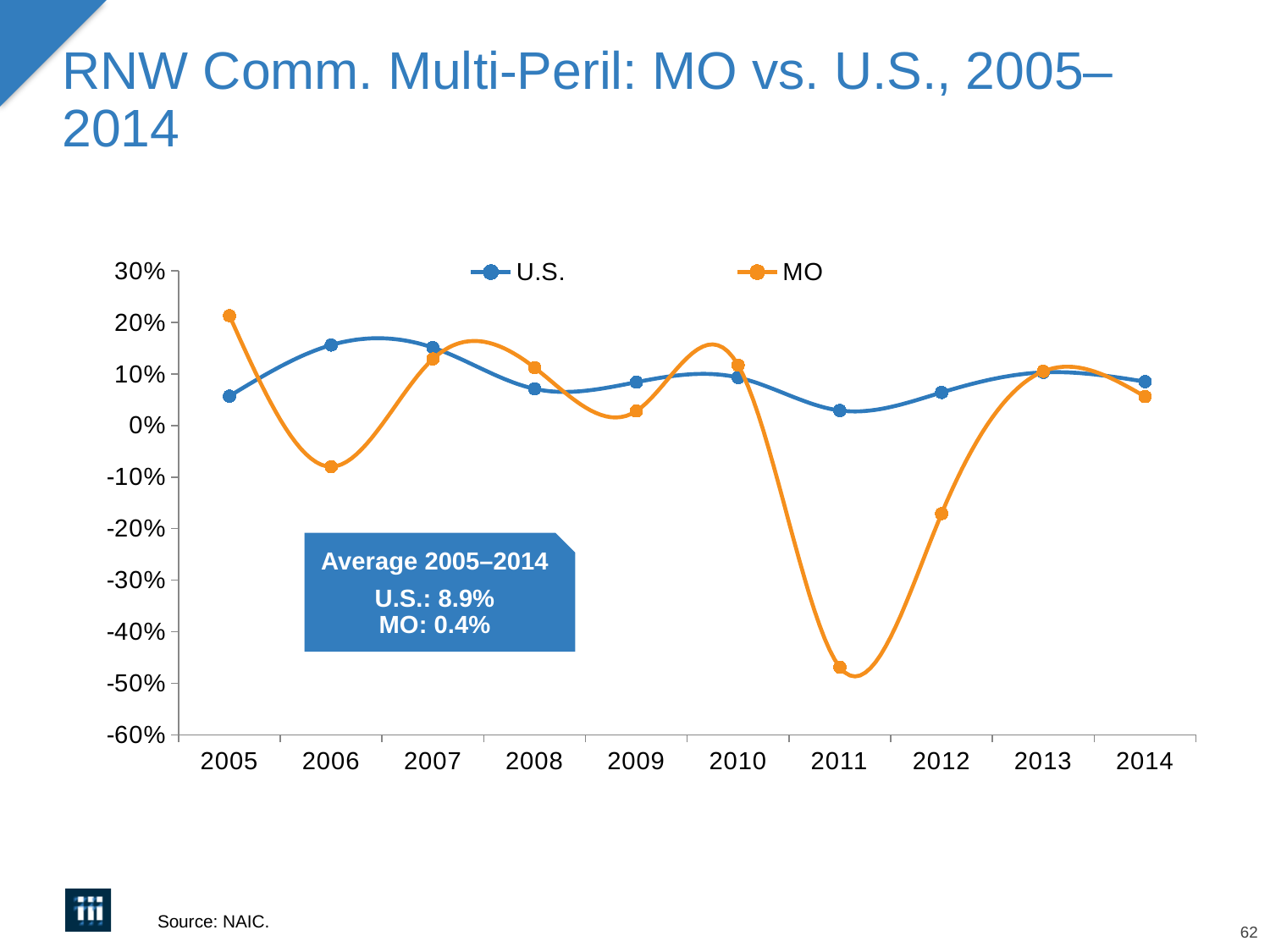
What kind of chart is shown on the slide? Line chart Is the value for MO in 2011 greater or less than -40%? less Is the value for U.S. in 2006 greater or less than 10%? greater Is the value for MO in 2012 greater or less than -10%? less In which year does the MO series reach its highest value? 2005 How many series does the legend list? 2 In 2011, which series has the larger value, U.S. or MO? U.S. In which year does the U.S. series reach its lowest value? 2011 In which year does the MO series reach its lowest value? 2011 How many years are plotted along the x axis? 10 In 2005, which series has the larger value, U.S. or MO? MO According to the text box on the chart, what is the 2005–2014 average for MO? 0.4%